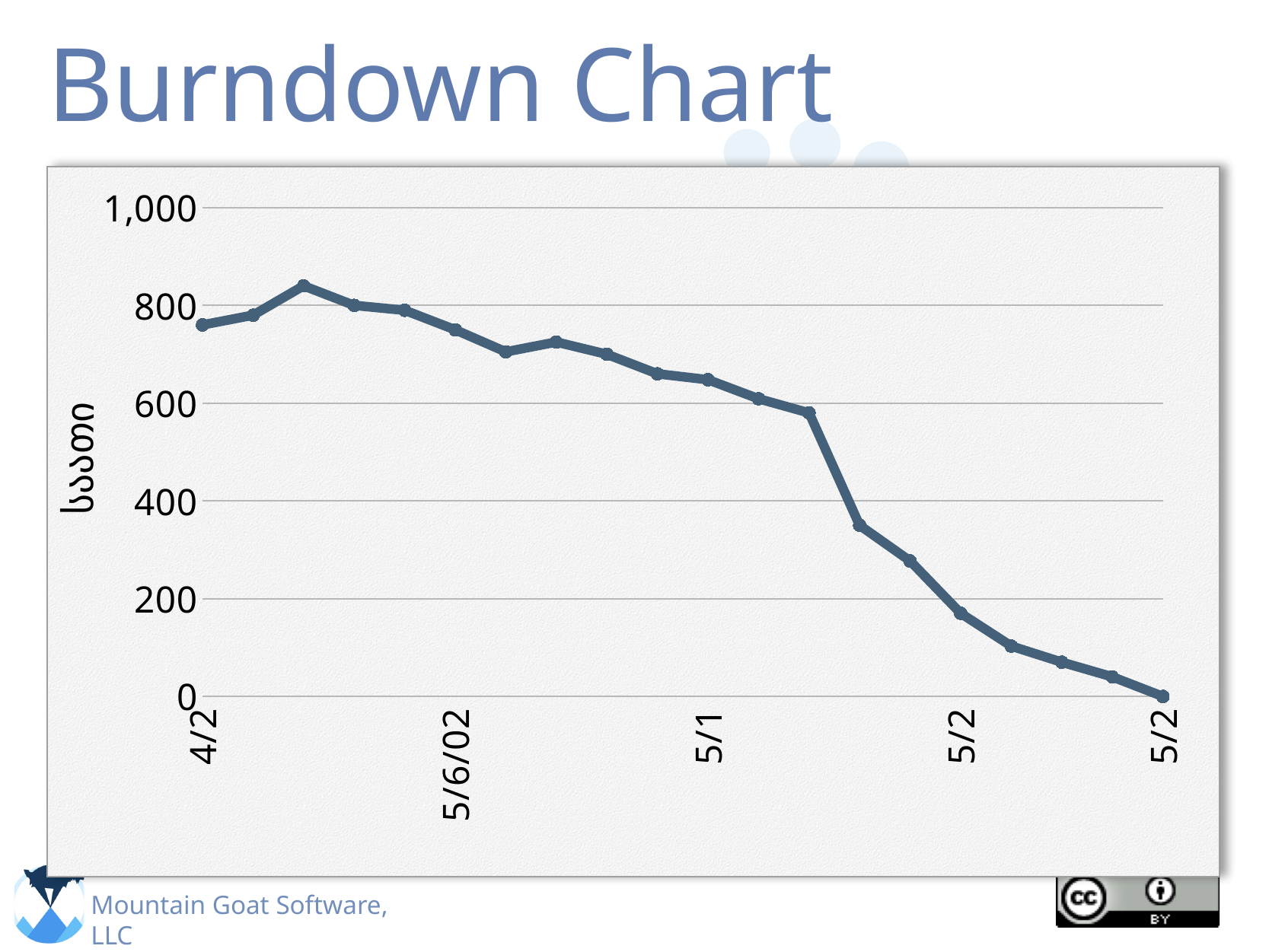
Which is larger, the value at 4/2 or the value at 5/1? 4/2 Is the value at 4/2 greater or less than 600? greater How many data points are plotted on the line? 20 Is the value at 5/6/02 greater or less than 600? greater What kind of chart is shown on the slide? line chart What is the value of the last point on the line? 0 Do the values generally rise or fall from left to right along the x axis? fall Is the value at the fourth x-axis label (5/2) greater or less than 400? less What is the title of the chart? Burndown Chart What is the highest value shown on the y axis? 1,000